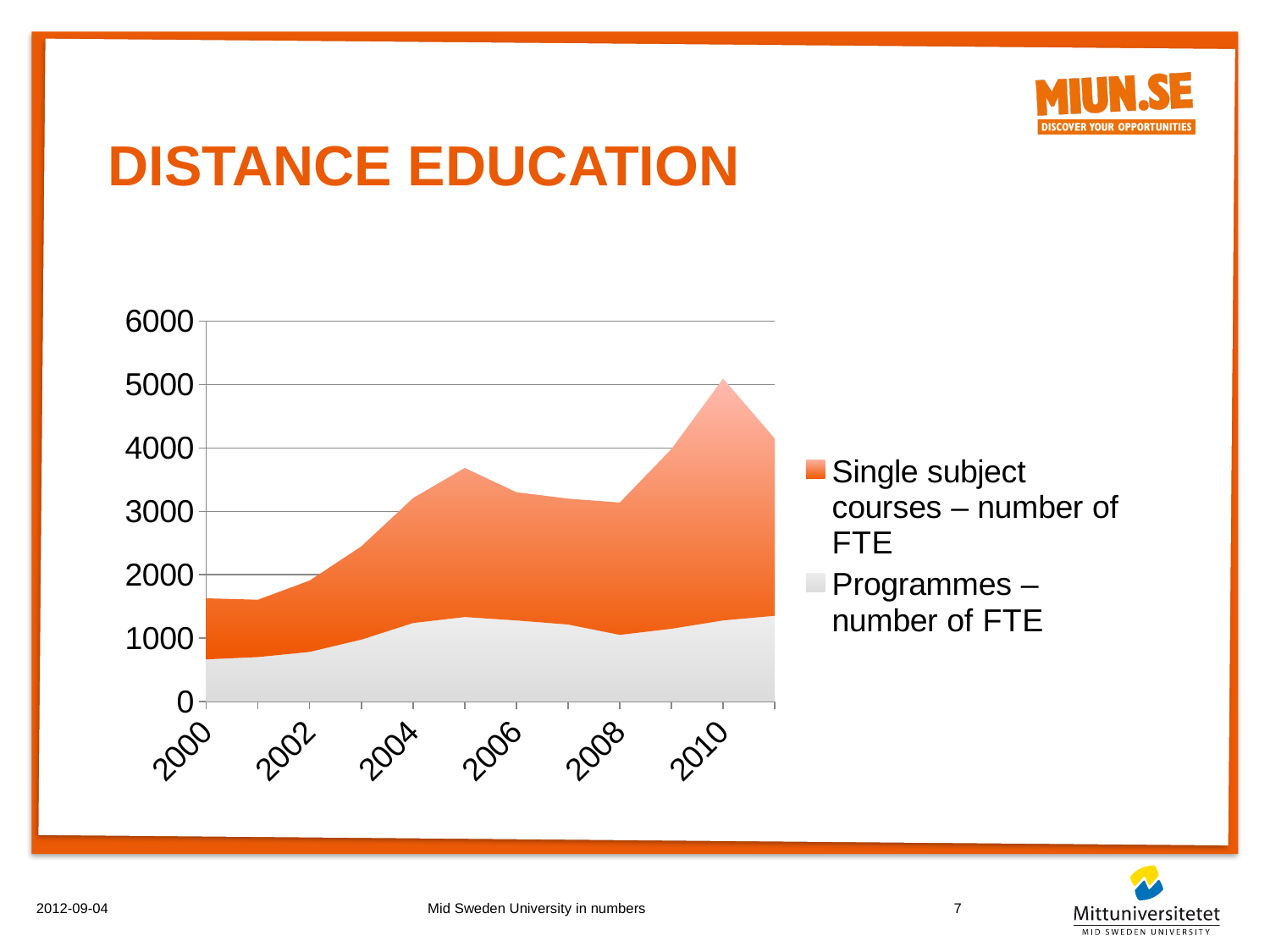
Is the total number of FTE in 2010 larger than in 2000? yes What is the title of the slide containing the chart? DISTANCE EDUCATION Does the total number of FTE generally rise or fall from 2000 to 2010? rise Is the value for Programmes – number of FTE in 2000 greater or less than 1000? less Which series is shown in orange? Single subject courses – number of FTE Is the total number of FTE in 2010 greater or less than 4000? greater Is the total number of FTE in 2008 greater or less than 4000? less In which year does the total number of FTE (both series combined) reach its highest point? 2010 What kind of chart is shown on the slide? area chart How many series does the legend list? 2